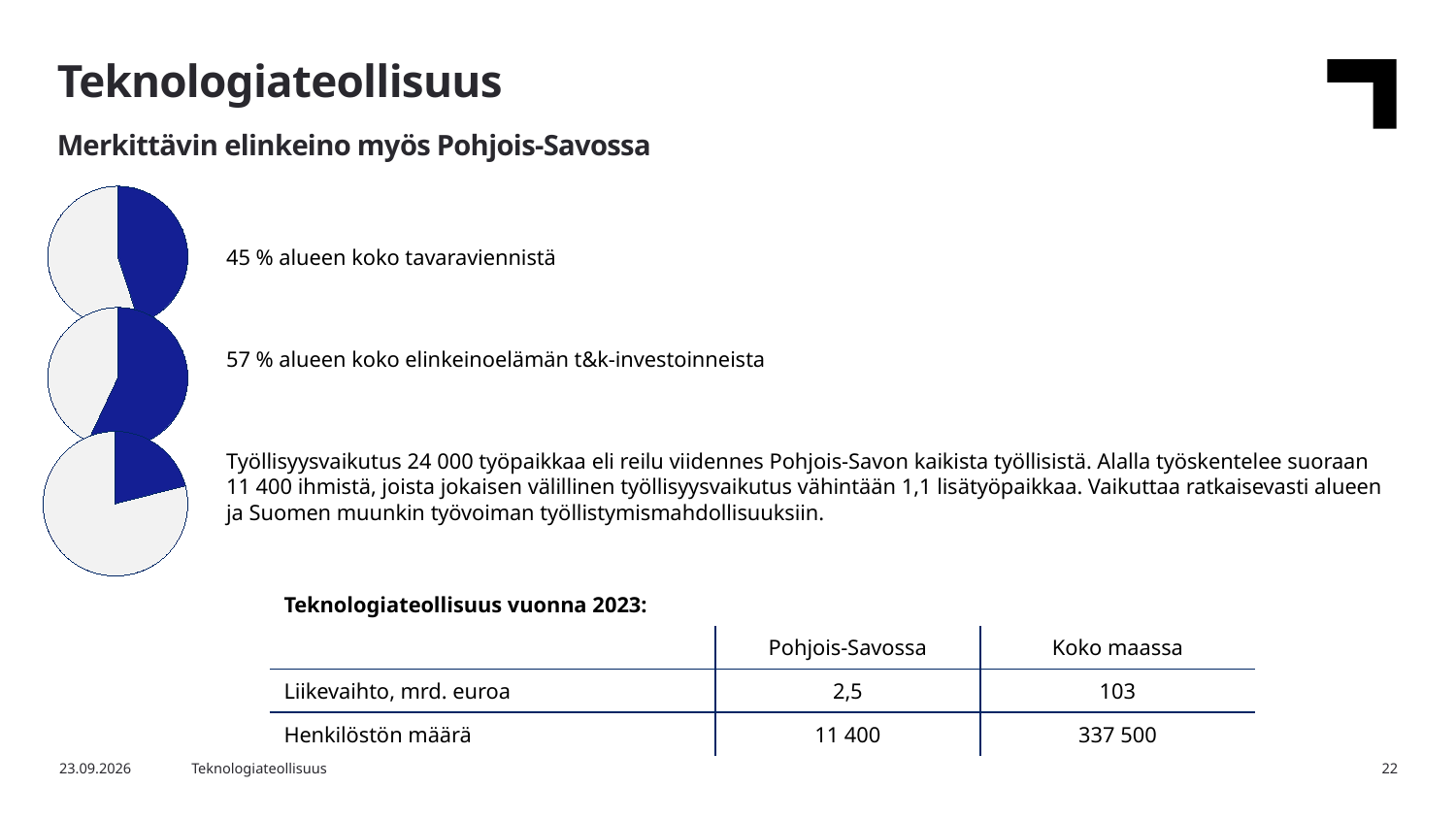
How many slices does each pie chart have? 2 What colour is the highlighted slice in the pie charts? Dark blue What is the difference in percentage points between the highlighted shares of the middle pie chart (57 %) and the top pie chart (45 %)? 12 percentage points Which of the three pie charts has the smallest highlighted slice? The bottom one (työllisyysvaikutus) What kind of chart is used on the left side of the slide? Pie chart In the top pie chart, what share of the region's total goods exports does the highlighted slice represent? 45 % Which pie chart has the larger highlighted slice, the top one (tavaravienti) or the middle one (t&k-investoinnit)? The middle one (t&k-investoinnit) Which of the three pie charts has the largest highlighted slice? The middle one (t&k-investoinnit) How many pie charts are shown on the slide? 3 In the middle pie chart, what share of the region's business R&D investments does the highlighted slice represent? 57 % What does the top pie chart's highlighted slice represent, according to the text next to it? 45 % alueen koko tavaraviennistä